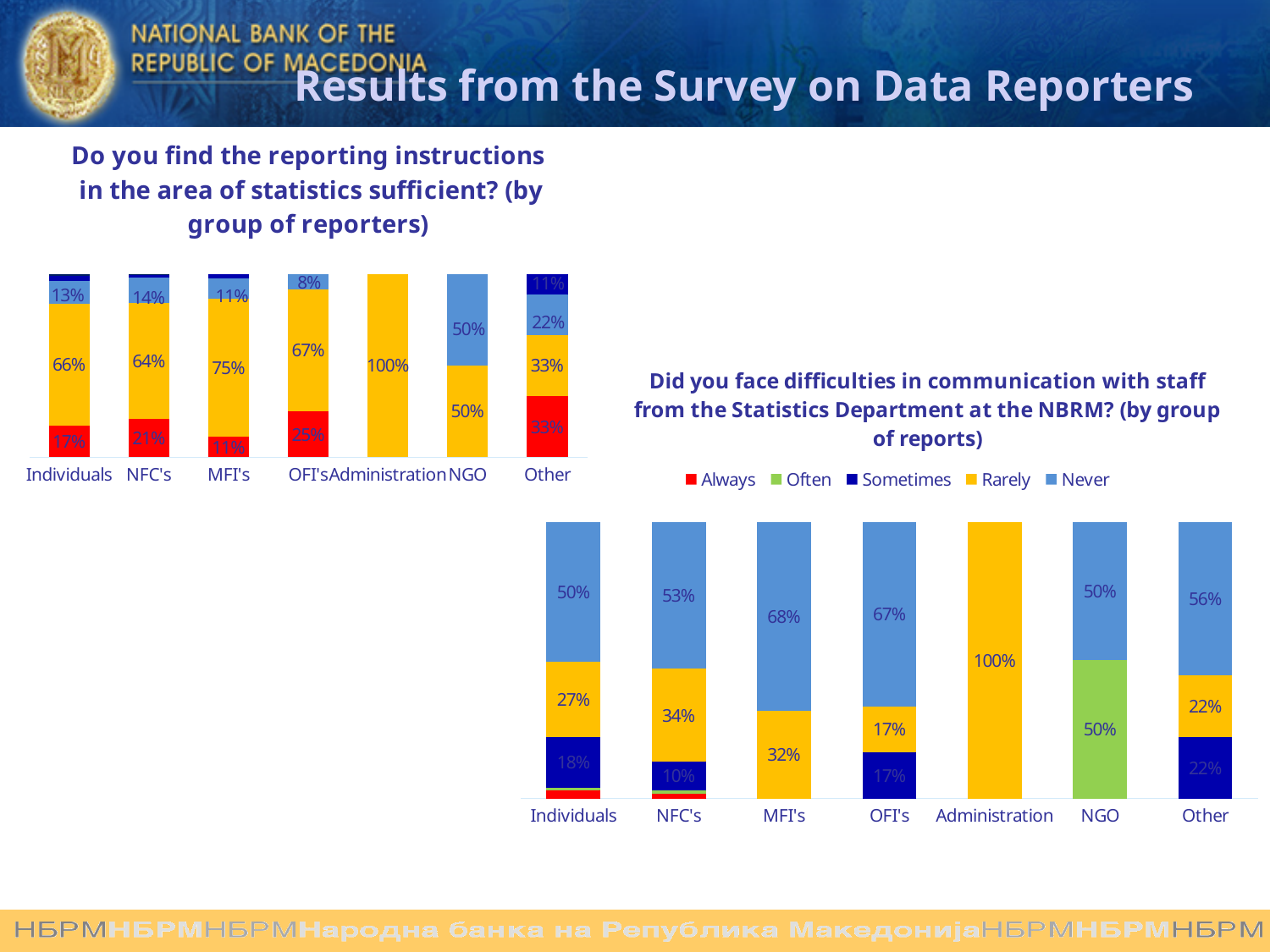
In the chart 'Did you face difficulties in communication with staff from the Statistics Department at the NBRM?', how many groups of reporters are shown on the x axis? 7 In the chart 'Did you face difficulties in communication with staff from the Statistics Department at the NBRM?', what is the 'Often' value for NGO? 50% In the chart 'Do you find the reporting instructions in the area of statistics sufficient?', what is the value of the yellow segment for MFI's? 75% In the chart 'Do you find the reporting instructions in the area of statistics sufficient?', which group has the largest yellow segment? Administration What kind of chart is 'Did you face difficulties in communication with staff from the Statistics Department at the NBRM?'? Stacked bar chart In the chart 'Did you face difficulties in communication with staff from the Statistics Department at the NBRM?', which is larger: the 'Rarely' value for NFC's or for Individuals? NFC's In the chart 'Did you face difficulties in communication with staff from the Statistics Department at the NBRM?', what is the 'Rarely' value for Administration? 100% In the chart 'Did you face difficulties in communication with staff from the Statistics Department at the NBRM?', how many series does the legend list? 5 In the chart 'Did you face difficulties in communication with staff from the Statistics Department at the NBRM?', what is the 'Never' value for MFI's? 68% In the chart 'Did you face difficulties in communication with staff from the Statistics Department at the NBRM?', what is the 'Sometimes' value for Other? 22% In the chart 'Did you face difficulties in communication with staff from the Statistics Department at the NBRM?', what is the difference between the 'Never' values for NFC's and Individuals? 3 percentage points In the chart 'Do you find the reporting instructions in the area of statistics sufficient?', what is the value of the red segment for Other? 33%